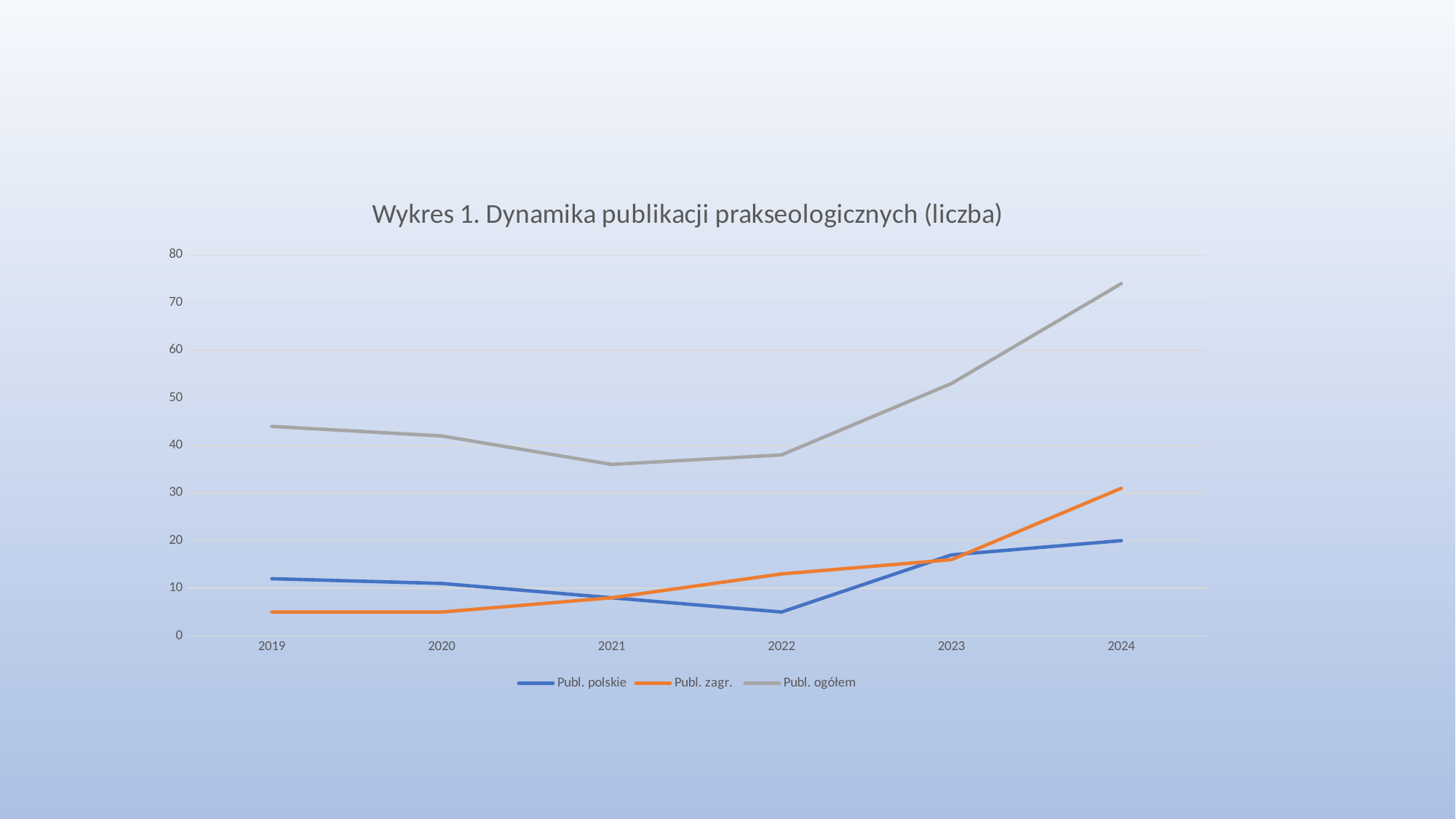
Is the value for Publ. ogółem in 2024 greater or less than 70? greater In 2019, which is larger: Publ. polskie or Publ. zagr.? Publ. polskie What kind of chart is shown on the slide? line chart How many years are shown on the x axis? 6 How many series does the legend list? 3 Does Publ. ogółem rise or fall from 2022 to 2024? rise In which year is Publ. polskie lowest? 2022 Is the value for Publ. zagr. in 2024 greater or less than 25? greater Is the value for Publ. ogółem in 2021 greater or less than 40? less In which year is Publ. ogółem highest? 2024 In 2024, which is larger: Publ. zagr. or Publ. polskie? Publ. zagr. In which year is Publ. ogółem lowest? 2021